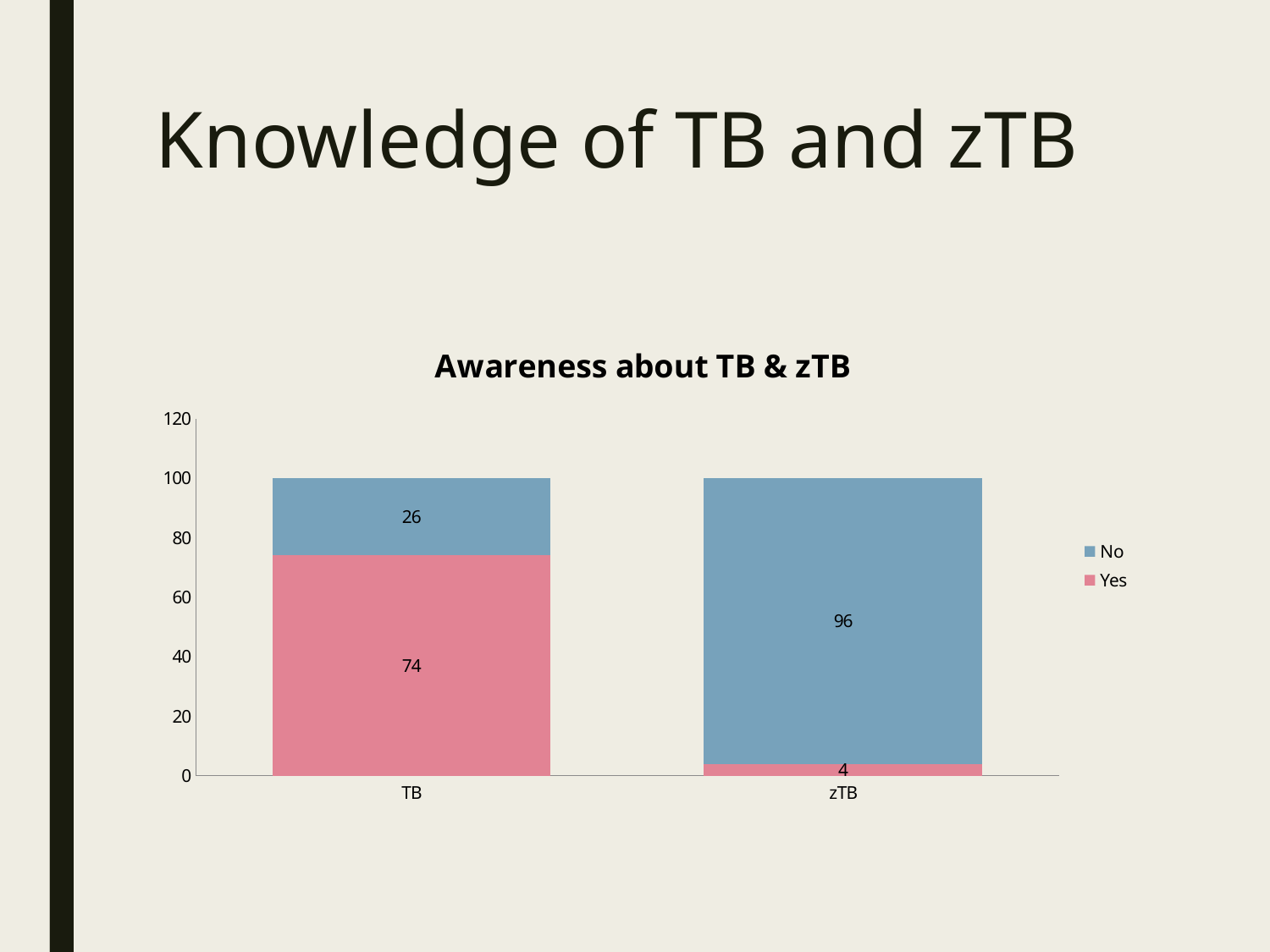
What kind of chart is shown on the slide? Stacked bar chart What is the value for "No" in the zTB category? 96 What is the value for "Yes" in the zTB category? 4 Which category has the lowest "No" value? TB What is the total of the stacked bar for TB? 100 What is the value for "Yes" in the TB category? 74 How many series does the legend list? 2 What is the difference between the "No" values for zTB and TB? 70 What is the value for "No" in the TB category? 26 What is the title of the chart? Awareness about TB & zTB How many categories are shown on the x axis? 2 Which category has the higher "Yes" value, TB or zTB? TB